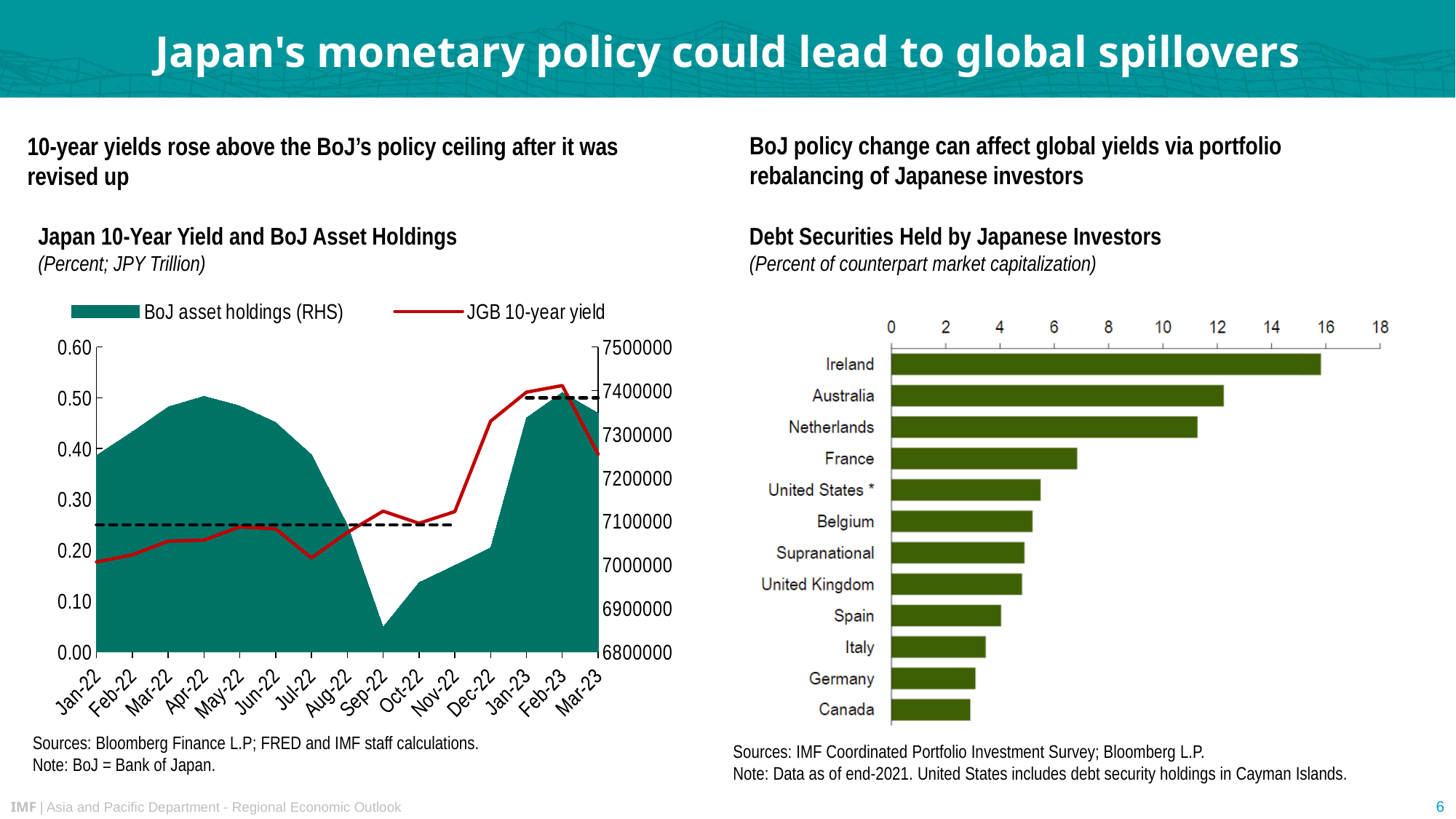
In the 'Debt Securities Held by Japanese Investors' chart, which entity has the highest value? Ireland How many countries or entities are shown in the 'Debt Securities Held by Japanese Investors' chart? 12 What kind of chart is the 'Debt Securities Held by Japanese Investors' chart? bar chart In the 'Japan 10-Year Yield and BoJ Asset Holdings' chart, in which month does the JGB 10-year yield reach its highest point? Feb-23 How many series does the legend of the 'Japan 10-Year Yield and BoJ Asset Holdings' chart list? 2 In the 'Debt Securities Held by Japanese Investors' chart, is the value for France greater or less than 8? less In the 'Japan 10-Year Yield and BoJ Asset Holdings' chart, in which month are BoJ asset holdings at their lowest? Sep-22 In the 'Debt Securities Held by Japanese Investors' chart, is the value for Ireland greater or less than 14? greater In the 'Debt Securities Held by Japanese Investors' chart, which entity has the lowest value? Canada In the 'Japan 10-Year Yield and BoJ Asset Holdings' chart, is the JGB 10-year yield in Dec-22 greater or less than 0.50? less In the 'Debt Securities Held by Japanese Investors' chart, which is larger, the value for Australia or the value for Netherlands? Australia How many months are shown on the x axis of the 'Japan 10-Year Yield and BoJ Asset Holdings' chart? 15